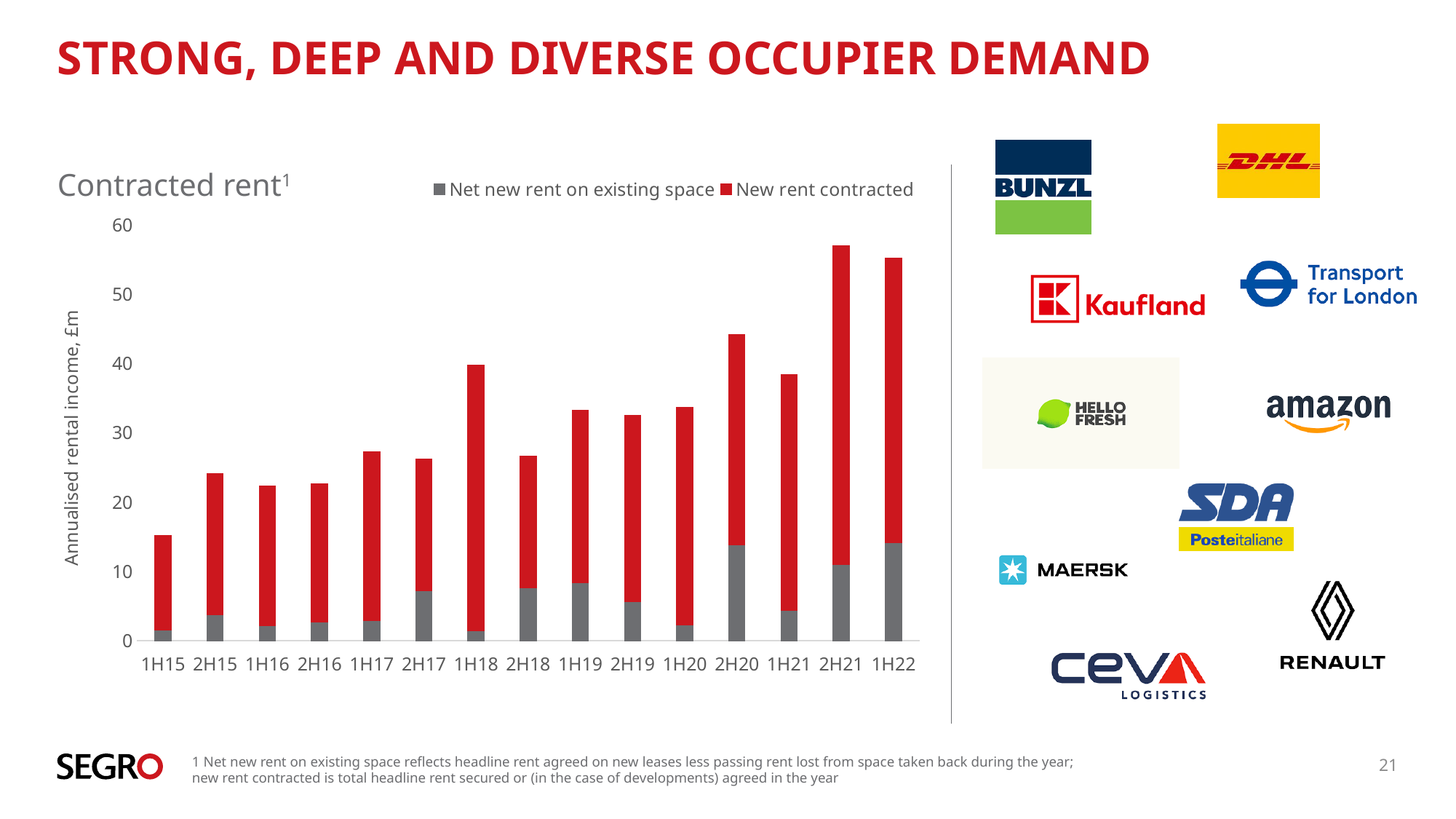
Is the total bar for 1H21 greater or less than 40? less What is the label on the y axis of the Contracted rent chart? Annualised rental income, £m Is the total bar for 2H21 greater or less than 50? greater Do the total bars generally rise or fall from 1H15 to 1H22? rise What kind of chart is shown under the heading 'Contracted rent'? Stacked bar chart How many series does the legend of the Contracted rent chart list? 2 How many half-year periods are shown on the x axis of the Contracted rent chart? 15 Is the total bar for 1H15 greater or less than 20? less Which period has the lowest total bar in the Contracted rent chart? 1H15 Which period has the highest total bar in the Contracted rent chart? 2H21 Which has the larger total bar, 1H18 or 2H18? 1H18